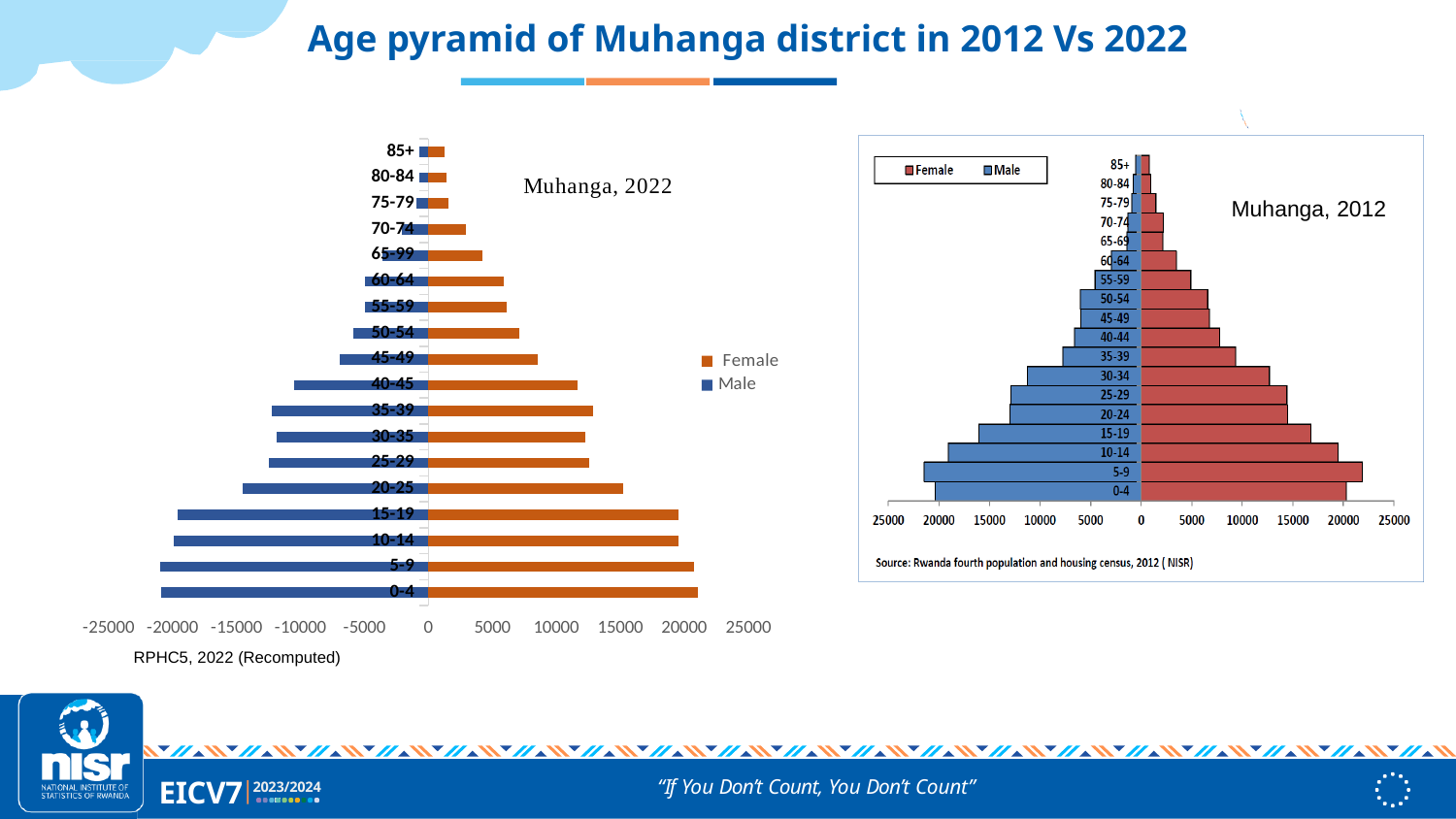
In the Muhanga, 2022 chart, which colour represents the Female series? Orange What source is cited below the Muhanga, 2012 chart? Rwanda fourth population and housing census, 2012 (NISR) In the Muhanga, 2022 chart, do the female bars generally get longer or shorter as the age groups get older? Shorter In the Muhanga, 2012 chart, which is larger: the female value for 5-9 or the female value for 30-34? 5-9 In the Muhanga, 2022 chart, is the female value for the 0-4 age group greater or less than 20000? greater In the Muhanga, 2012 chart, is the female value for the 5-9 age group greater or less than 20000? greater How many age groups are shown on the Muhanga, 2022 chart? 18 In the Muhanga, 2022 chart, which age group has the smallest female value? 85+ What kind of chart is the Muhanga, 2022 chart on the left? Bar chart In the Muhanga, 2022 chart, is the female value for the 45-49 age group greater or less than 10000? less In the Muhanga, 2012 chart, which age group has the largest female value? 5-9 How many series does the legend of the Muhanga, 2022 chart list? 2